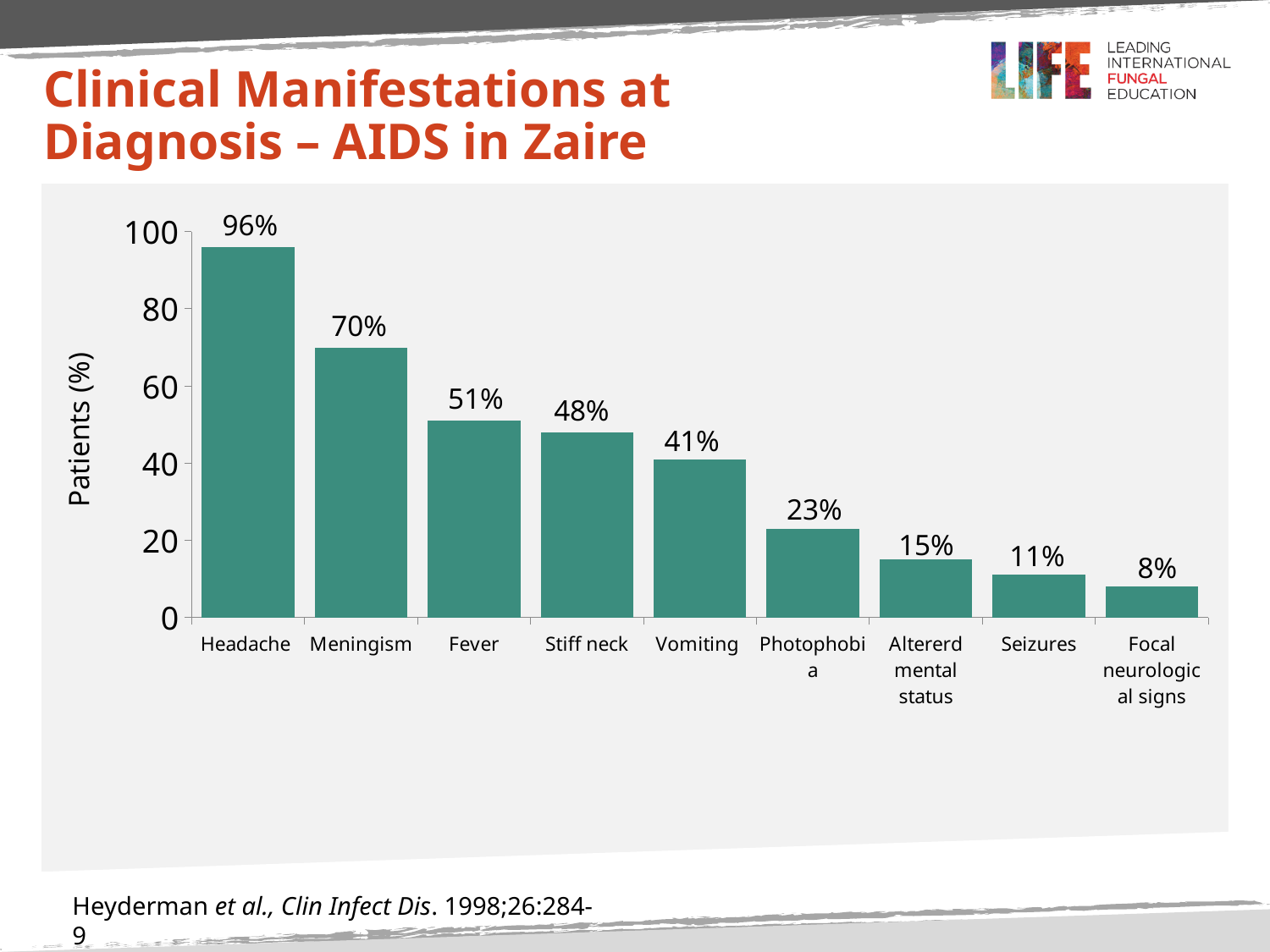
What percentage of patients had altered mental status? 15% What is the value shown for Vomiting? 41% What is the difference between the percentages for Headache and Meningism? 26% What kind of chart is shown on the slide? Bar chart Which clinical manifestation has the lowest percentage of patients? Focal neurological signs What is the label of the y axis? Patients (%) What percentage of patients had headache at diagnosis? 96% Which clinical manifestation has the highest percentage of patients? Headache What is the difference between the percentages for Fever and Stiff neck? 3% How many clinical manifestations are shown on the x axis? 9 Is the value for Meningism greater or less than 60? greater Which is larger, the value for Photophobia or the value for Seizures? Photophobia